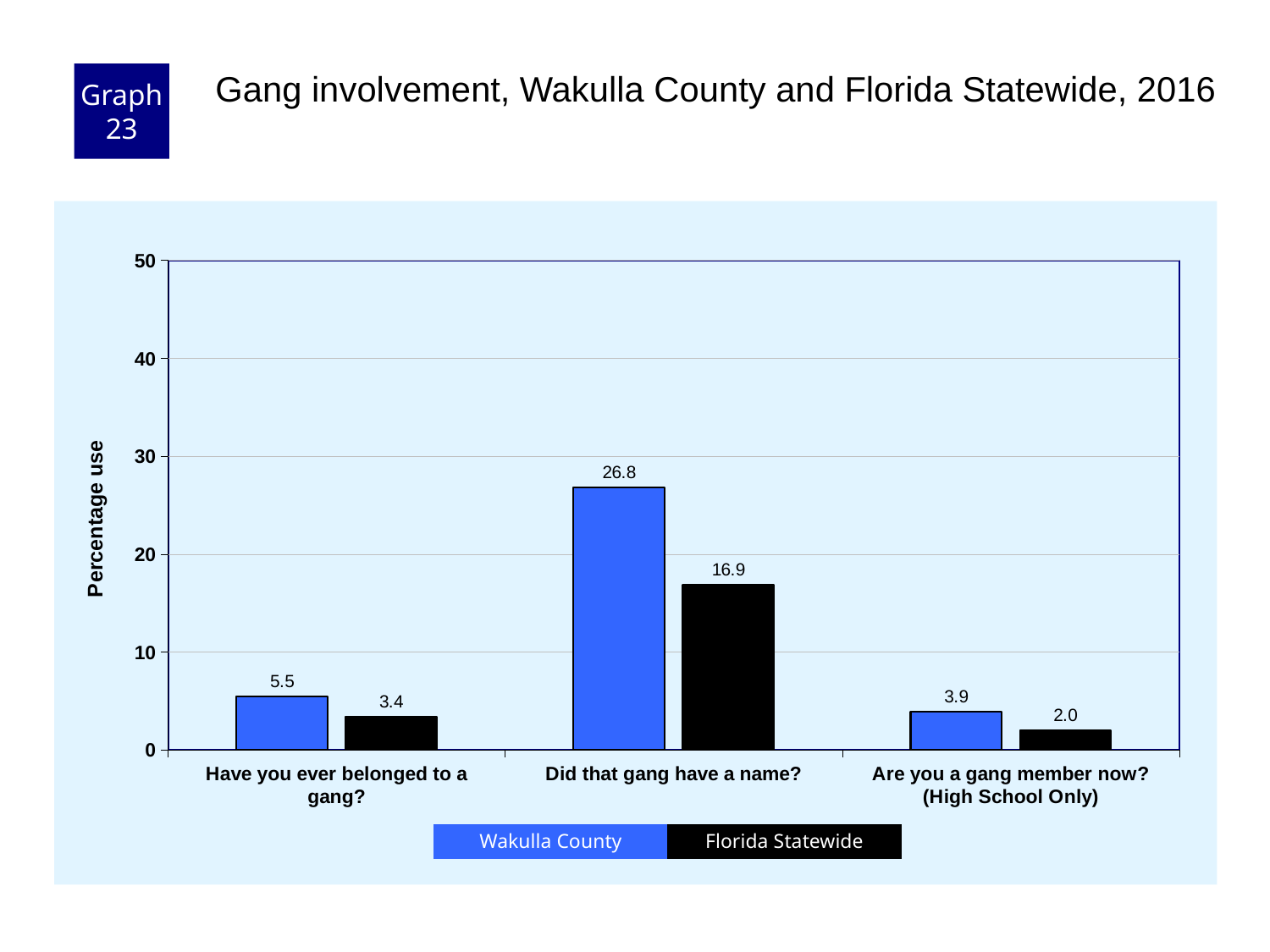
How many series does the legend list? 2 Is the Florida Statewide value for "Did that gang have a name?" greater or less than 20? less What is the Florida Statewide value for "Have you ever belonged to a gang?"? 3.4 What is the Wakulla County value for "Did that gang have a name?"? 26.8 Which question has the lowest Florida Statewide value? Are you a gang member now? (High School Only) What kind of chart is shown on the slide? bar chart Which question has the highest Wakulla County value? Did that gang have a name? What is the label on the y axis? Percentage use How many question categories are shown on the x axis? 3 For "Have you ever belonged to a gang?", which is larger: Wakulla County or Florida Statewide? Wakulla County What is the Florida Statewide value for "Are you a gang member now? (High School Only)"? 2.0 What is the difference between the Wakulla County and Florida Statewide values for "Did that gang have a name?"? 9.9